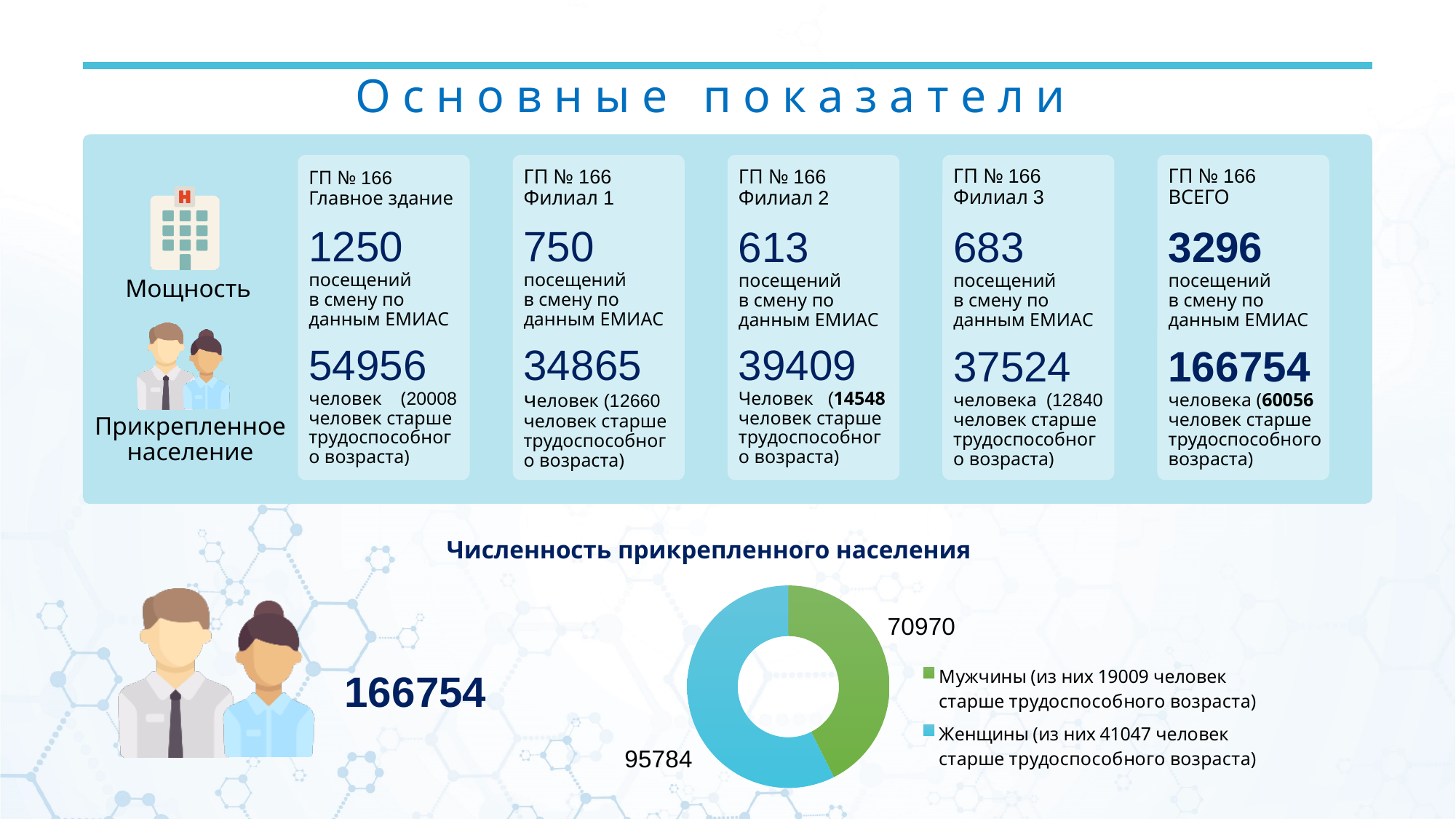
According to the legend of the chart "Численность прикрепленного населения", how many women are older than working age? 41047 In the chart "Численность прикрепленного населения", which is larger: Мужчины or Женщины? Женщины How many slices does the chart "Численность прикрепленного населения" have? 2 In the chart "Численность прикрепленного населения", which category has the largest slice? Женщины In the chart "Численность прикрепленного населения", what is the difference between the values for Женщины and Мужчины? 24814 In the chart "Численность прикрепленного населения", which category has the smallest slice? Мужчины In the chart "Численность прикрепленного населения", what is the value for Мужчины? 70970 In the chart "Численность прикрепленного населения", what colour is the Мужчины slice? Green How many entries does the legend of the chart "Численность прикрепленного населения" list? 2 What kind of chart is shown under the title "Численность прикрепленного населения"? Pie (donut) chart In the chart "Численность прикрепленного населения", what is the total of the two slices? 166754 In the chart "Численность прикрепленного населения", what is the value for Женщины? 95784